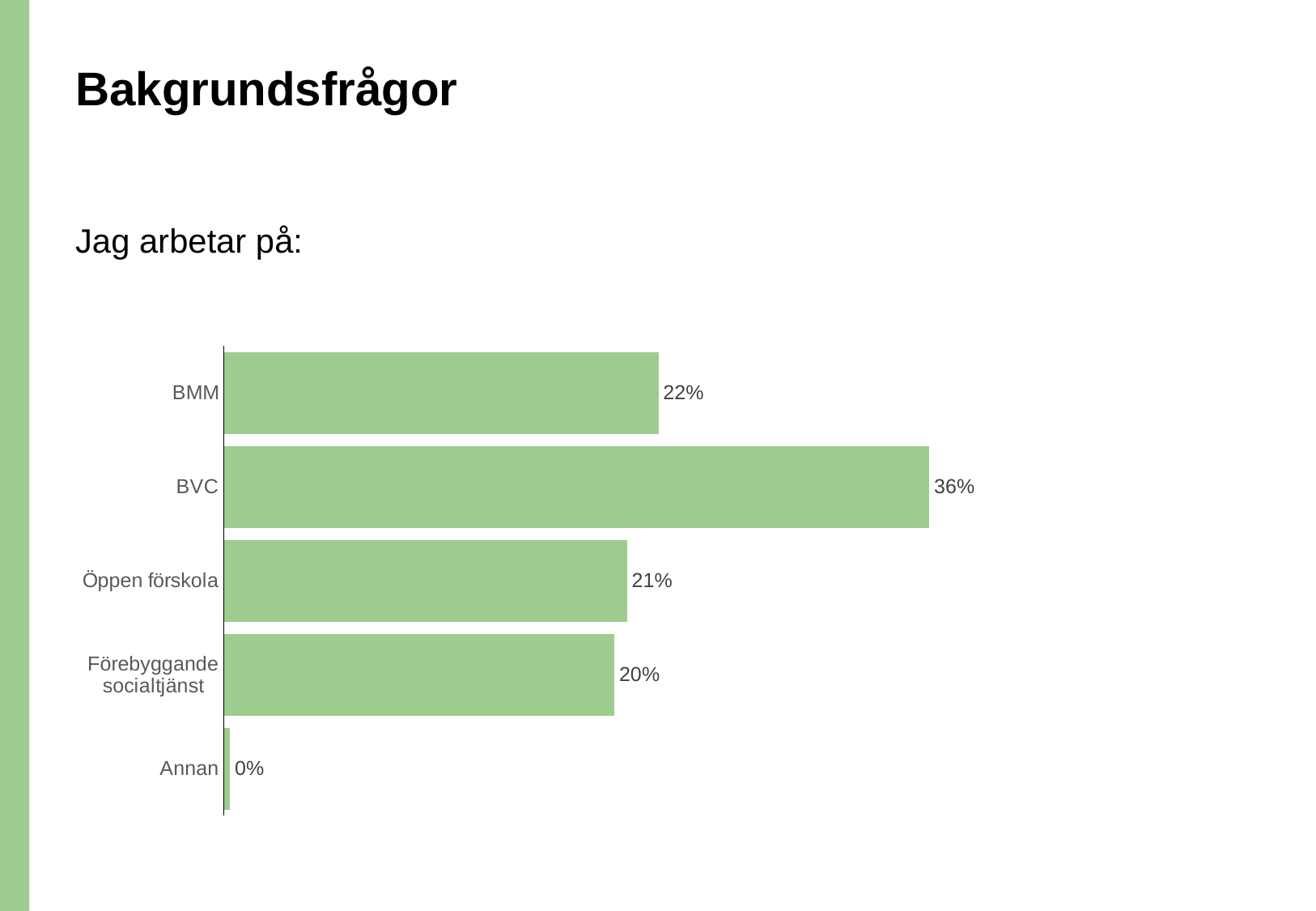
Which is larger, the value for BMM or the value for Förebyggande socialtjänst? BMM What is the question text shown above the chart? Jag arbetar på: What kind of chart is shown on the slide? Bar chart What is the value for BVC? 36% Which category has the lowest value? Annan What is the value for BMM? 22% What is the value for Öppen förskola? 21% What is the difference between the values for BVC and BMM? 14% What is the value for Annan? 0% Which category has the highest value? BVC How many categories are shown in the chart? 5 What is the value for Förebyggande socialtjänst? 20%